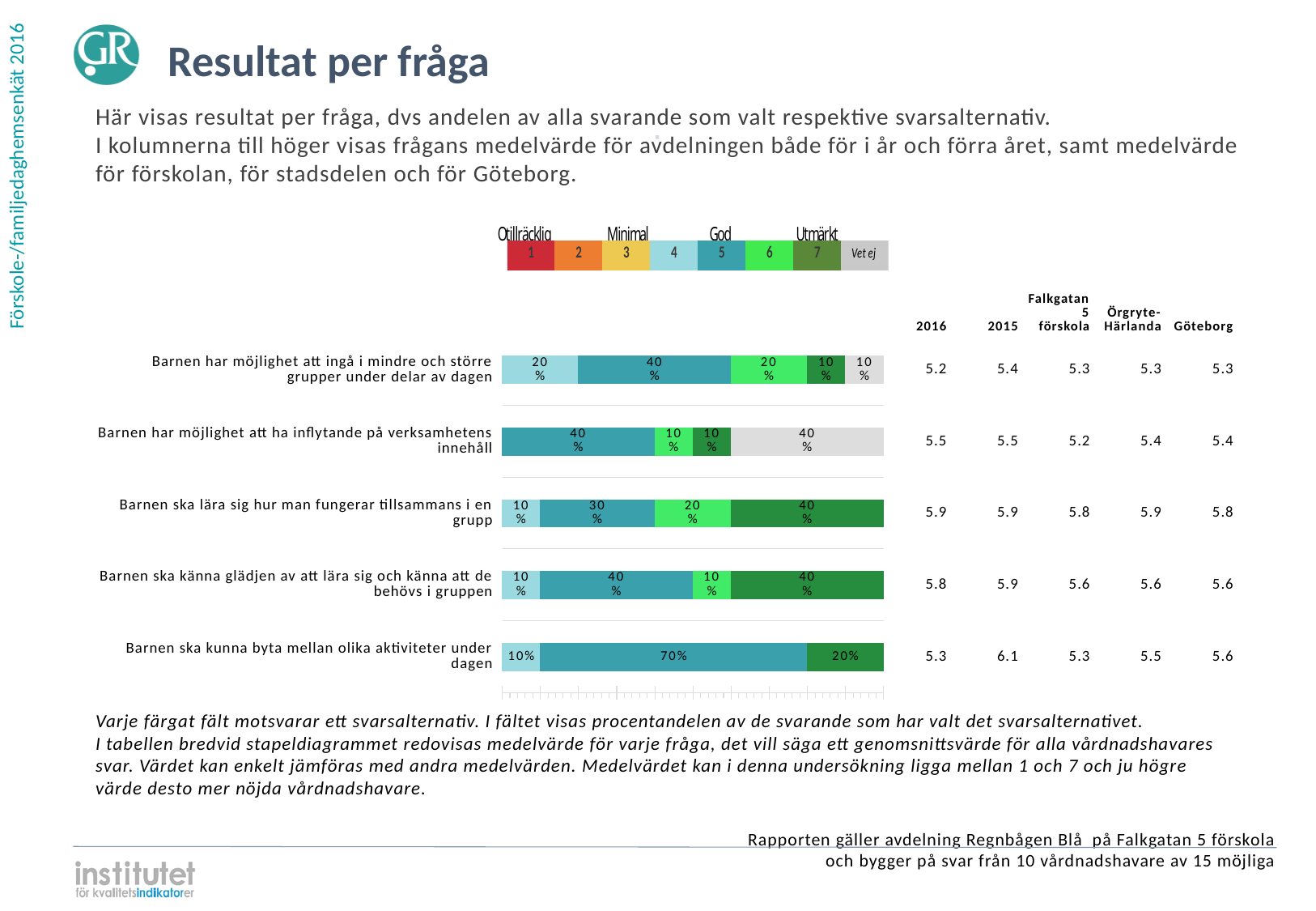
How many answer options does the colour legend above the chart list, including 'Vet ej'? 8 What percentage of respondents answered 'Vet ej' for 'Barnen har möjlighet att ha inflytande på verksamhetens innehåll'? 40% How many questions (categories) are plotted in the bar chart? 5 For 'Barnen har möjlighet att ingå i mindre och större grupper under delar av dagen', which is larger: the share for option 5 or the share for option 6? Option 5 What is the Göteborg mean value for 'Barnen har möjlighet att ha inflytande på verksamhetens innehåll'? 5.4 What kind of chart is shown on the slide? Stacked bar chart What percentage of respondents chose option 5 for 'Barnen ska kunna byta mellan olika aktiviteter under dagen'? 70% What is the 2015 mean value for 'Barnen ska kunna byta mellan olika aktiviteter under dagen'? 6.1 What percentage of respondents chose option 7 for 'Barnen ska lära sig hur man fungerar tillsammans i en grupp'? 40% Which question has the largest single segment in its bar? Barnen ska kunna byta mellan olika aktiviteter under dagen What is the 2016 mean value for 'Barnen ska lära sig hur man fungerar tillsammans i en grupp'? 5.9 What is the difference between the option 5 share and the option 7 share for 'Barnen ska kunna byta mellan olika aktiviteter under dagen'? 50%